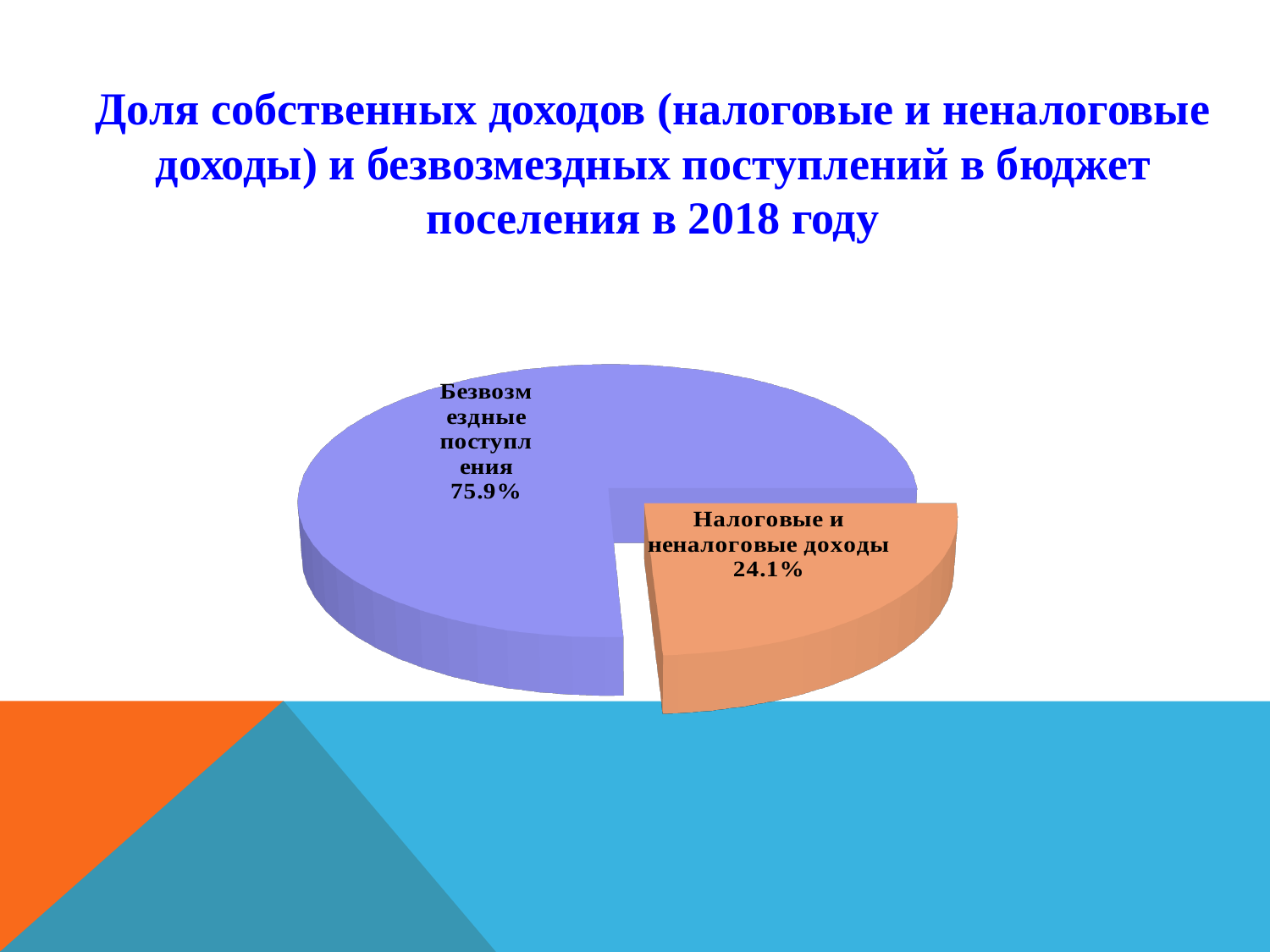
How many slices does the pie chart have? 2 Which slice of the pie is the smallest? Налоговые и неналоговые доходы Which year does the chart title refer to? 2018 What share of the pie does "Безвозмездные поступления" represent? 75.9% Which is larger: the share for "Безвозмездные поступления" or the share for "Налоговые и неналоговые доходы"? Безвозмездные поступления What is the difference in percentage points between the "Безвозмездные поступления" slice and the "Налоговые и неналоговые доходы" slice? 51.8 What colour is the "Налоговые и неналоговые доходы" slice? Orange Which slice of the pie is the largest? Безвозмездные поступления What kind of chart is shown on the slide? Pie chart What share of the pie does "Налоговые и неналоговые доходы" represent? 24.1%